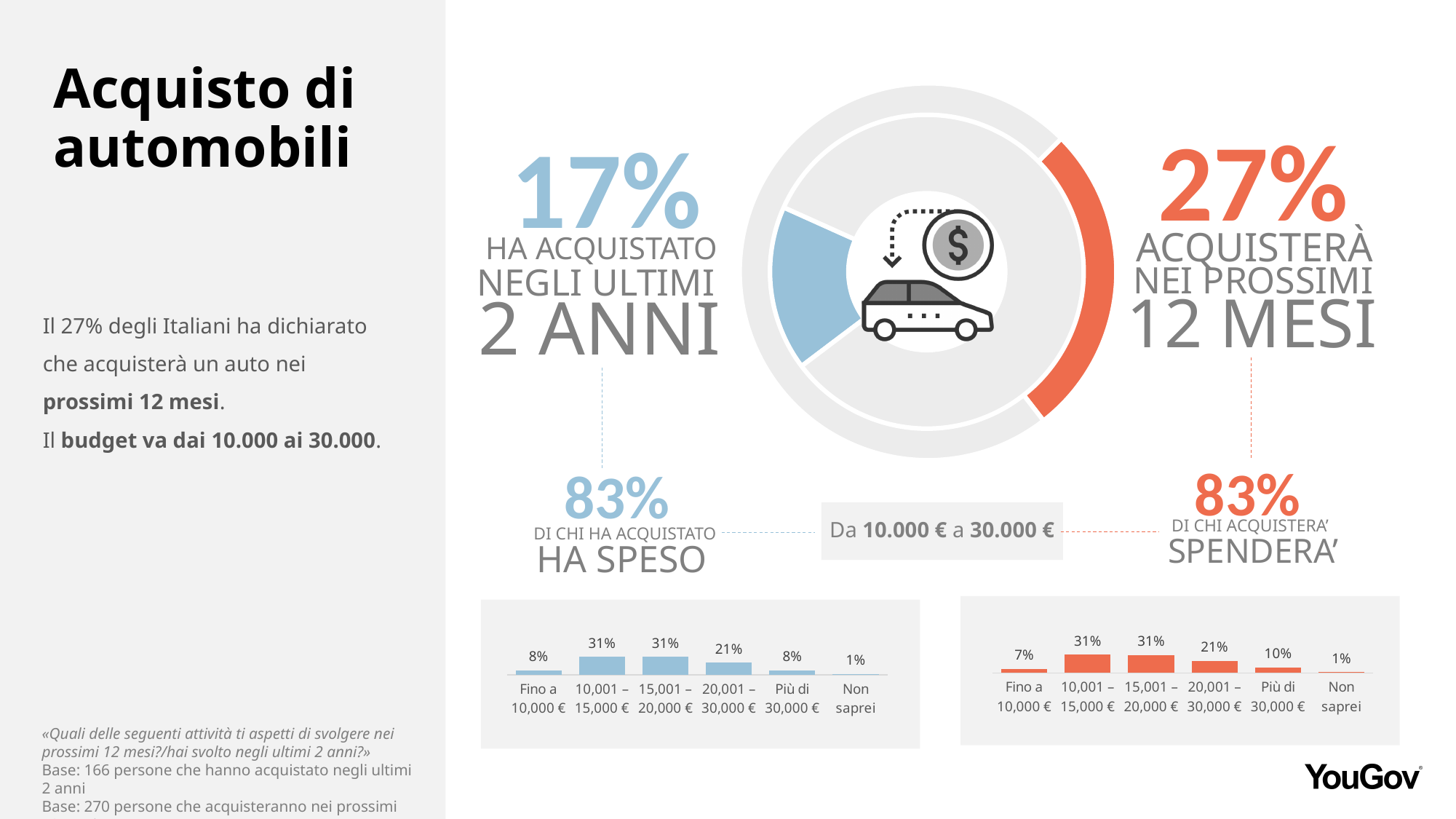
In the central gauge chart, what percentage is shown for 'acquisterà nei prossimi 12 mesi'? 27% What type of chart is used for the spending breakdown at the bottom right of the slide? Bar chart How many categories does the left bar chart (blue) show? 6 In the right bar chart (orange), which category has the lowest value? Non saprei In the right bar chart (orange), which is larger: the value for 'Più di 30,000 €' or the value for 'Fino a 10,000 €'? Più di 30,000 € In the right bar chart (orange, 'di chi acquisterà spenderà'), what is the value for 'Più di 30,000 €'? 10% In the left bar chart (blue), which category has the lowest value? Non saprei In the left bar chart (blue), what is the value for '20,001 – 30,000 €'? 21% In the left bar chart (blue, 'di chi ha acquistato ha speso'), what is the value for 'Fino a 10,000 €'? 8% In the left bar chart (blue), what is the difference between the values for '15,001 – 20,000 €' and '20,001 – 30,000 €'? 10% In the right bar chart (orange), what is the difference between the values for 'Più di 30,000 €' and 'Fino a 10,000 €'? 3% In the right bar chart (orange), what is the value for 'Fino a 10,000 €'? 7%